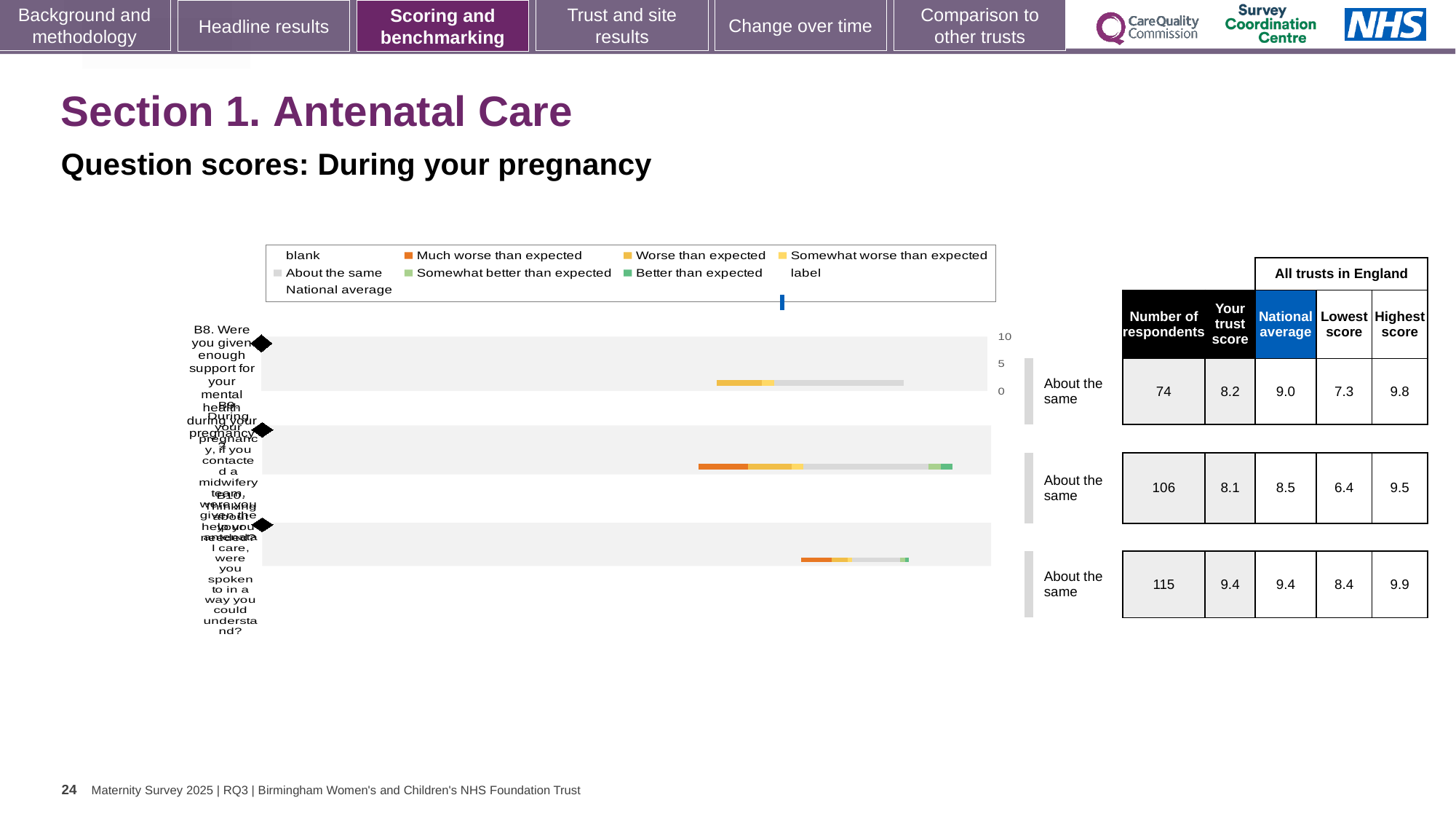
What is the trust score for the question with 106 respondents? 8.1 What is the number of respondents for the first question (B8, support for your mental health during pregnancy)? 74 What is the national average for the third question (115 respondents)? 9.4 What benchmark category is shown next to each of the three questions? About the same What is the highest score among all trusts in England for the question with 115 respondents? 9.9 For the first question (74 respondents), what is the difference between the national average and the trust score? 0.8 For the first question (74 respondents), which is larger: the trust score or the national average? the national average (9.0) In the legend, what category does the dark orange colour represent? Much worse than expected Which question has the highest trust score? the third question (115 respondents), 9.4 What is the lowest score among all trusts in England for the question with 106 respondents? 6.4 How many questions (bars) are plotted in the chart? 3 What kind of chart is shown on the slide? bar chart